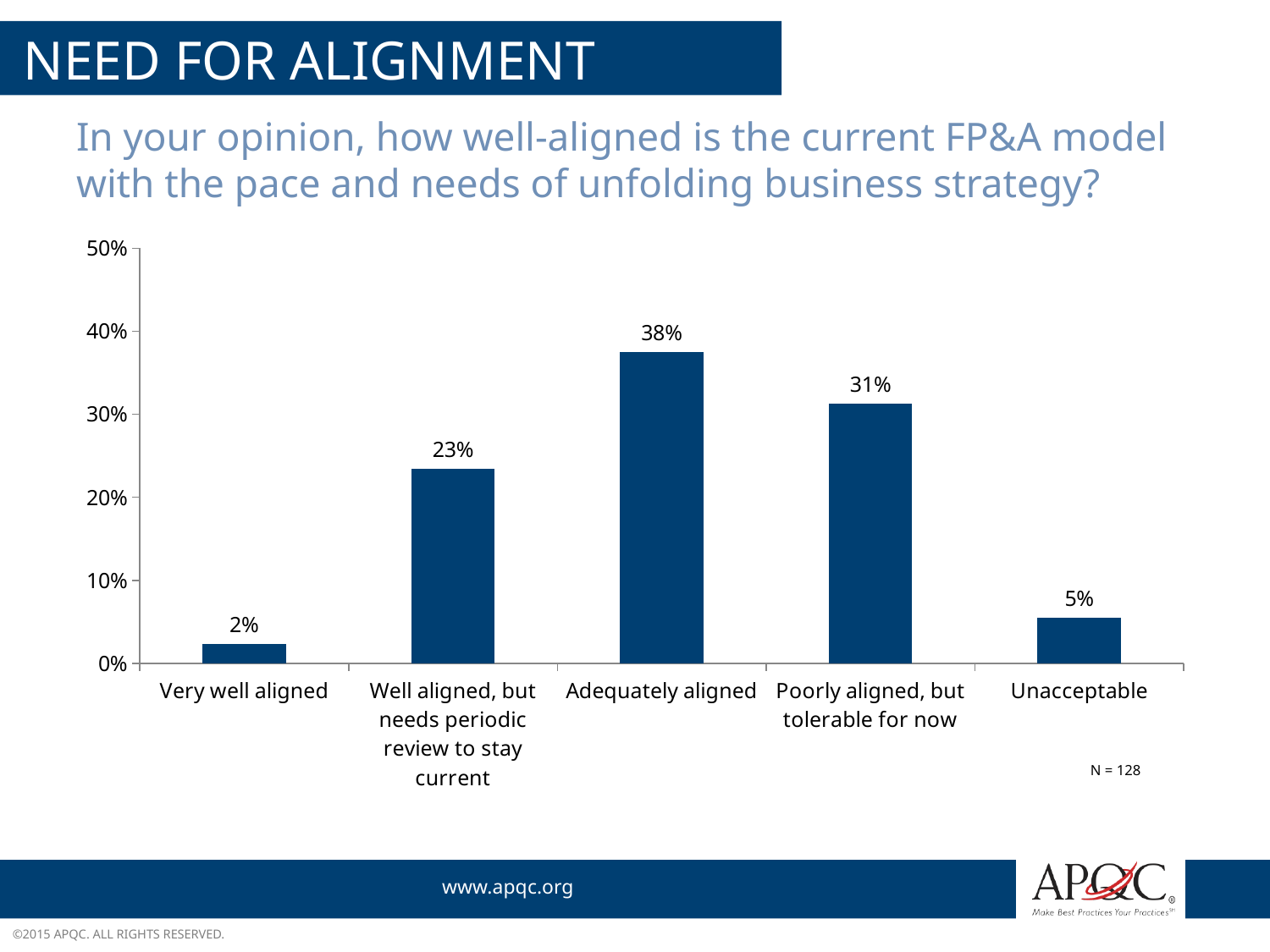
What kind of chart is shown on the slide? Bar chart Which category has the lowest value? Very well aligned What is the value for "Very well aligned"? 2% What percentage of respondents said the FP&A model is "Adequately aligned"? 38% Which is larger: "Poorly aligned, but tolerable for now" or "Well aligned, but needs periodic review to stay current"? Poorly aligned, but tolerable for now What is the sample size (N) noted on the slide? N = 128 Is the value for "Adequately aligned" greater or less than 30%? greater How many categories are shown on the x axis? 5 What is the value for "Poorly aligned, but tolerable for now"? 31% Which category has the highest value? Adequately aligned What is the value for "Unacceptable"? 5% What is the difference between "Adequately aligned" and "Well aligned, but needs periodic review to stay current"? 15%